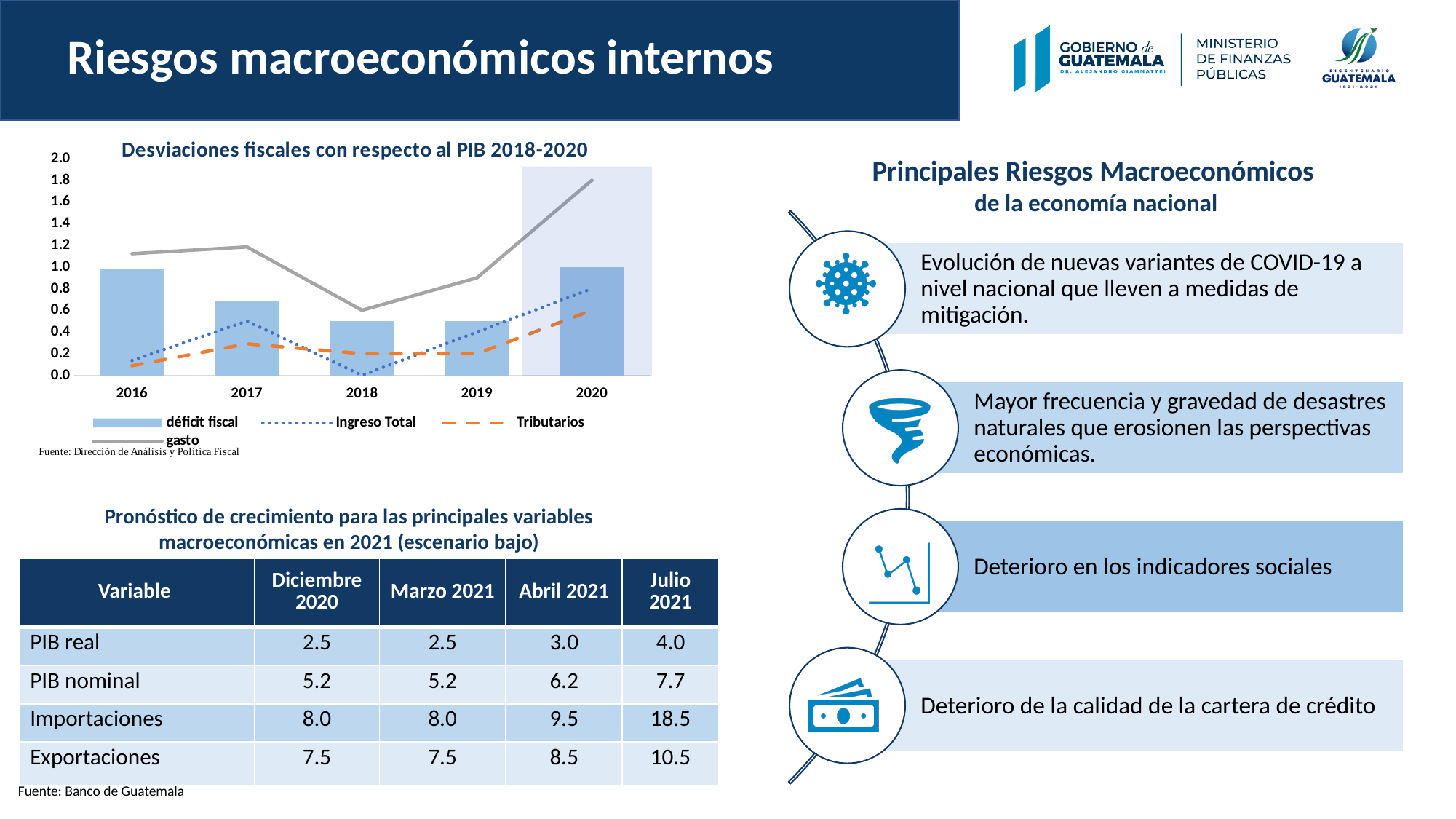
What kind of chart is "Desviaciones fiscales con respecto al PIB 2018-2020"? A combined bar and line chart In the "Desviaciones fiscales con respecto al PIB 2018-2020" chart, is the gasto value for 2018 greater or less than 0.8? less In the "Desviaciones fiscales con respecto al PIB 2018-2020" chart, which is larger, the déficit fiscal bar for 2016 or for 2017? 2016 In the "Desviaciones fiscales con respecto al PIB 2018-2020" chart, is the déficit fiscal bar for 2017 greater or less than 0.6? greater In the "Desviaciones fiscales con respecto al PIB 2018-2020" chart, which series is higher in 2020, Ingreso Total or Tributarios? Ingreso Total How many years are shown on the x axis of the "Desviaciones fiscales con respecto al PIB 2018-2020" chart? 5 In the "Desviaciones fiscales con respecto al PIB 2018-2020" chart, in which year is the gasto line lowest? 2018 In the "Desviaciones fiscales con respecto al PIB 2018-2020" chart, does the gasto line rise or fall from 2018 to 2020? rise In the "Desviaciones fiscales con respecto al PIB 2018-2020" chart, in which year is the gasto line highest? 2020 In the "Desviaciones fiscales con respecto al PIB 2018-2020" chart, is the gasto value for 2020 greater or less than 1.6? greater How many series does the legend of the "Desviaciones fiscales con respecto al PIB 2018-2020" chart list? 4 In the "Desviaciones fiscales con respecto al PIB 2018-2020" chart, in which year is Ingreso Total lowest? 2018